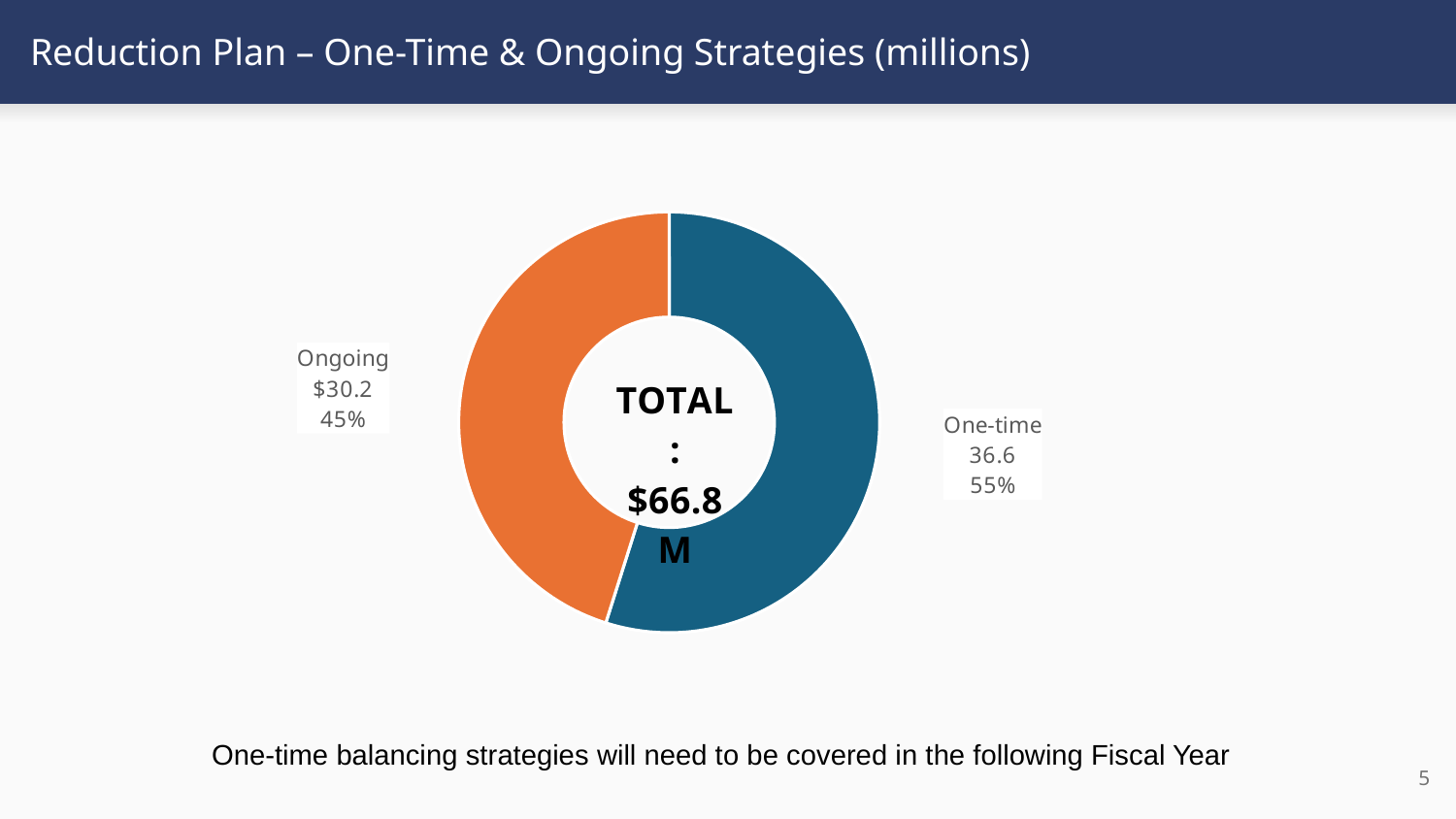
What percentage share does the One-time slice represent? 55% What is the value shown for the Ongoing slice? $30.2 How many slices does the chart have? 2 What is the difference between the One-time value and the Ongoing value? 6.4 What is the value shown for the One-time slice? 36.6 Which category has the smallest share of the chart? Ongoing What colour is the One-time slice? blue What kind of chart is shown on the slide? doughnut chart Which slice is larger, One-time or Ongoing? One-time What percentage share does the Ongoing slice represent? 45% What total is shown in the center of the chart? $66.8 M Which category has the largest share of the chart? One-time